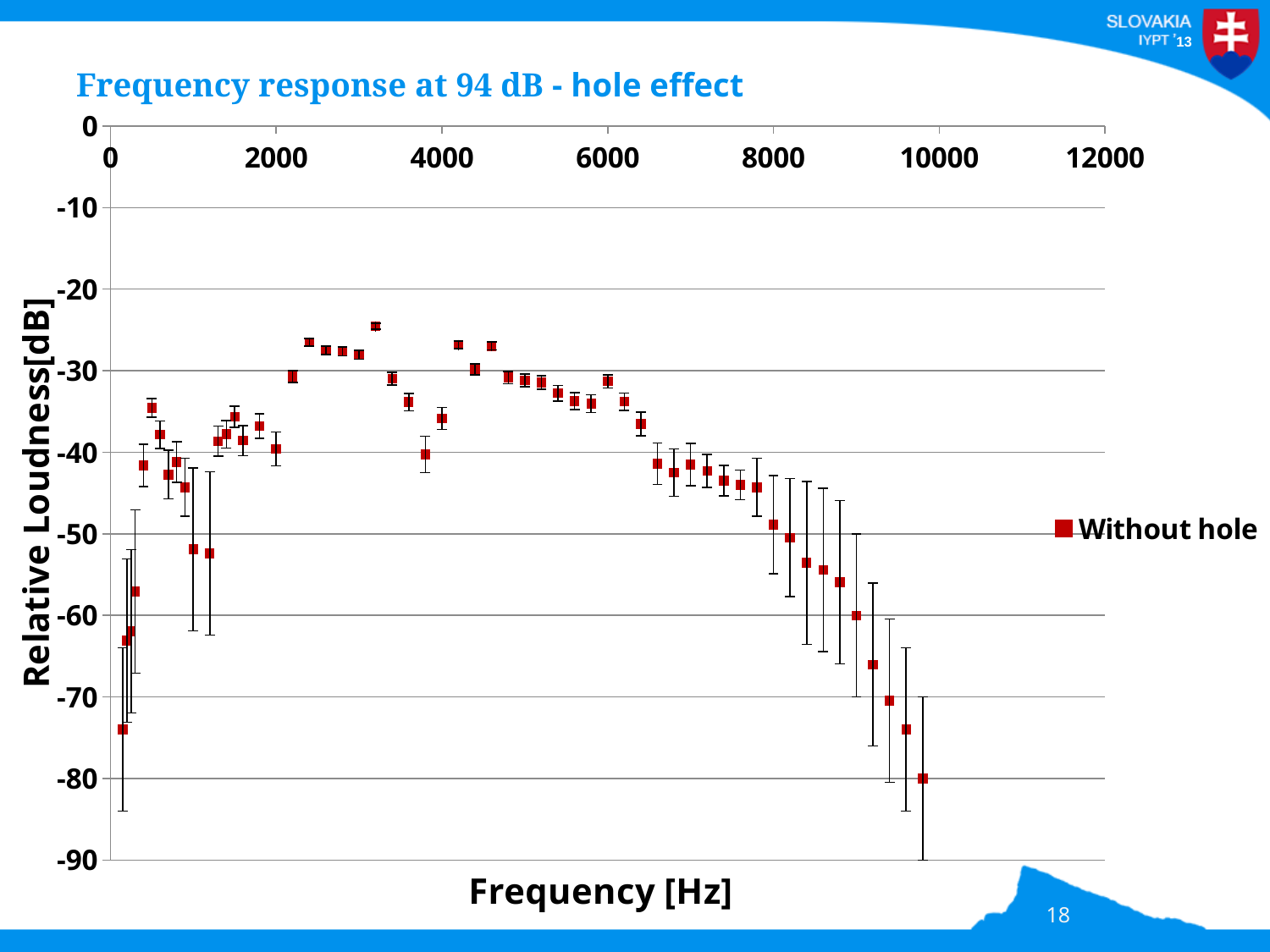
What is the title of the chart? Frequency response at 94 dB - hole effect Do the values rise or fall as frequency increases from 6000 Hz to 8000 Hz? fall Which is larger, the value at 8000 Hz or the value at 6000 Hz? 6000 Hz Is the value for the point at 8000 Hz greater or less than -40 dB? less Is the value for the point at about 3200 Hz greater or less than -30 dB? greater Do the values rise or fall as frequency increases from 8000 Hz to 10000 Hz? fall Is the value for the first point, near 0 Hz, greater or less than -60 dB? less What is the name of the series shown in the legend? Without hole How many series does the legend list? 1 What kind of chart is shown on the slide? Scatter chart